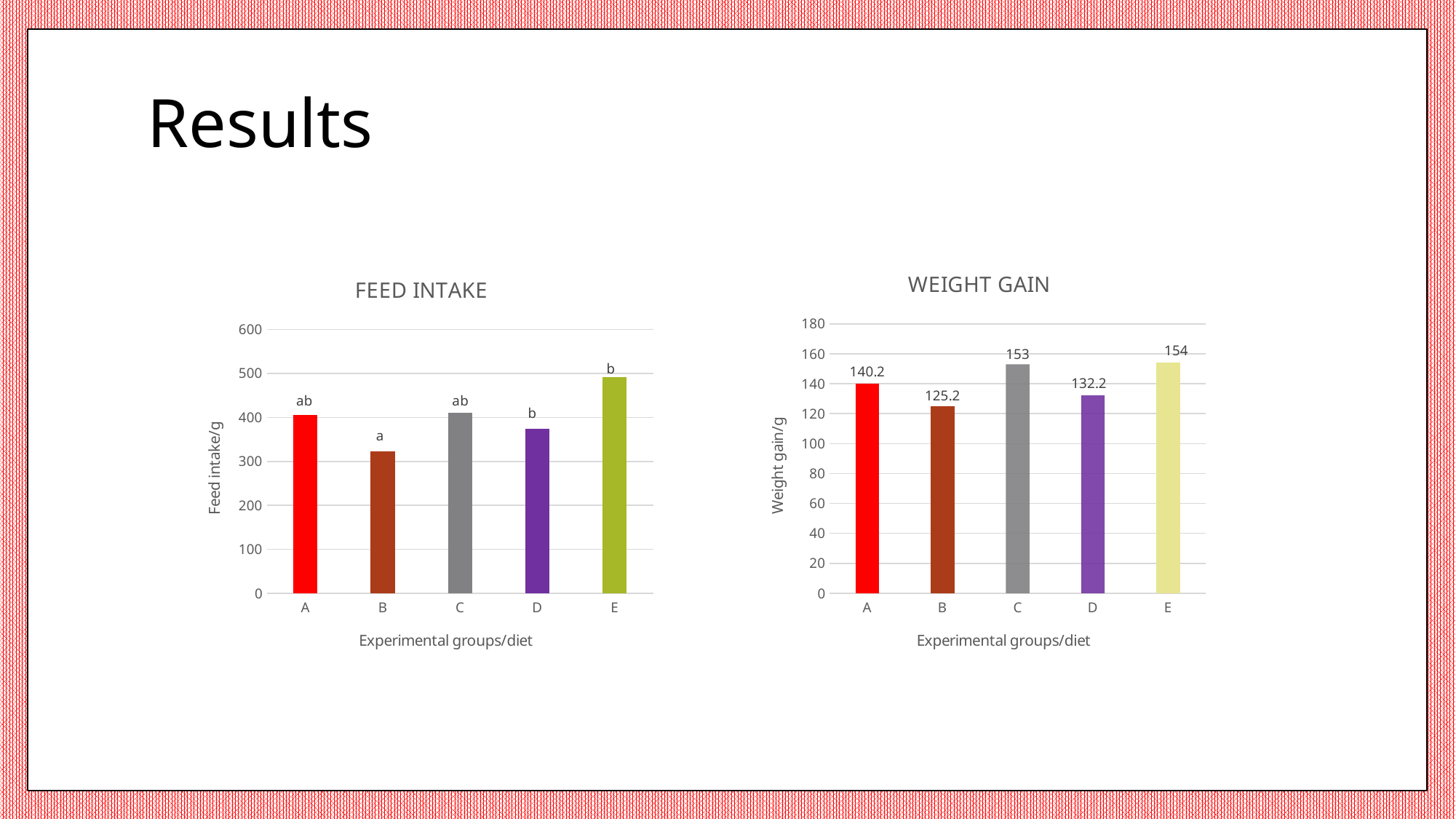
On the FEED INTAKE chart, is the value for group D greater or less than 300? greater On the FEED INTAKE chart, what letter label is printed above the bar for group B? a What type of chart is the WEIGHT GAIN chart? Bar chart On the FEED INTAKE chart, which experimental group has the lowest feed intake? B On the FEED INTAKE chart, is the value for group B greater or less than 400? less On the WEIGHT GAIN chart, how many experimental groups are shown on the x axis? 5 On the FEED INTAKE chart, is the value for group E greater or less than 400? greater On the WEIGHT GAIN chart, which experimental group has the lowest weight gain? B On the FEED INTAKE chart, which experimental group has the highest feed intake? E On the WEIGHT GAIN chart, what is the difference between the weight gain of group C and group D? 20.8 On the WEIGHT GAIN chart, what is the weight gain for group D? 132.2 On the WEIGHT GAIN chart, what is the weight gain for group A? 140.2